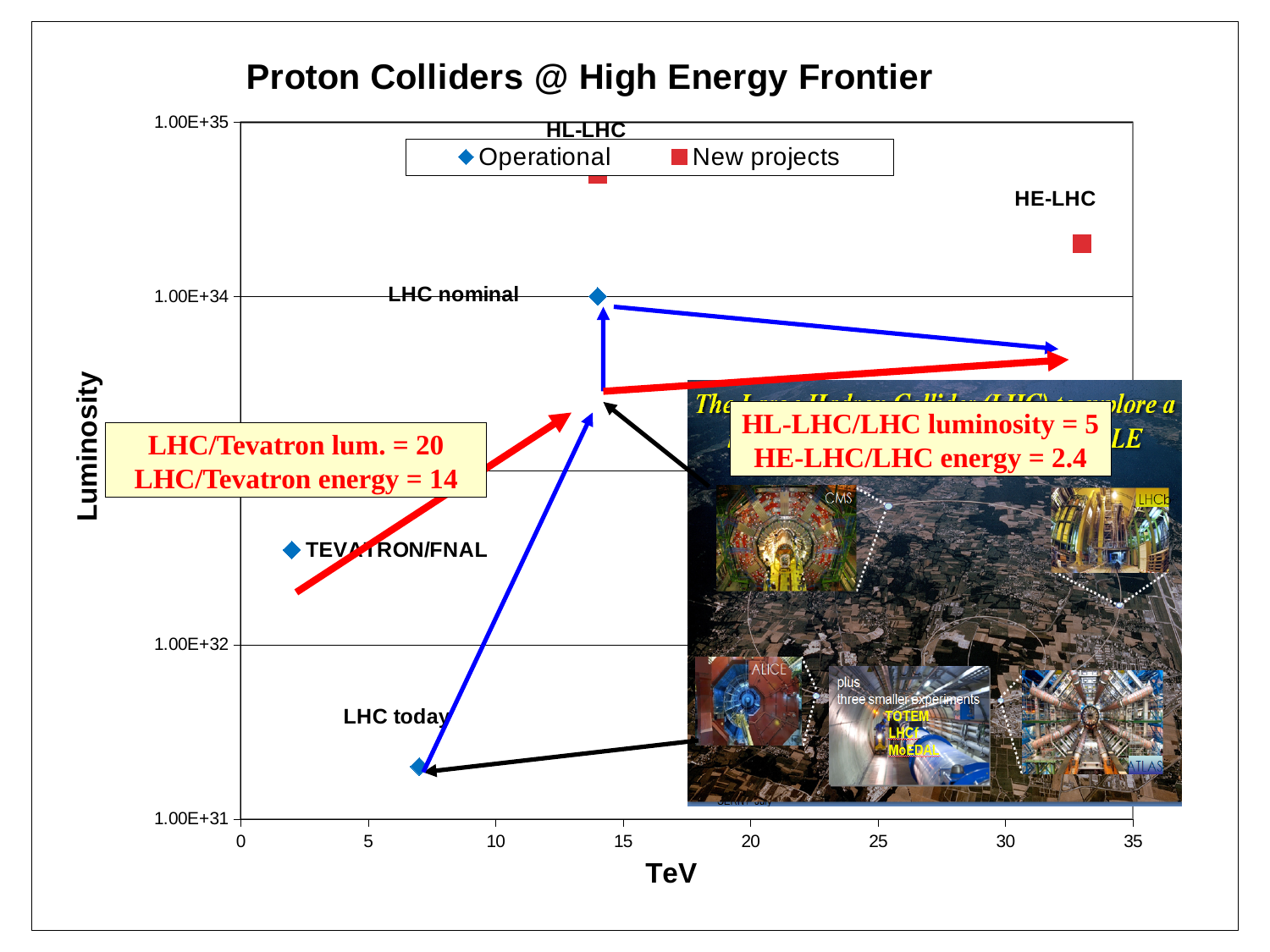
Which collider has the lowest luminosity on the chart? LHC today Is the luminosity for HE-LHC greater or less than 1.00E+34? greater Is the luminosity for TEVATRON/FNAL greater or less than 1.00E+32? greater Which collider has the highest luminosity on the chart? HL-LHC What are the two series named in the legend? Operational and New projects Which has the higher luminosity, HL-LHC or HE-LHC? HL-LHC What luminosity is plotted for LHC nominal? 1.00E+34 What is the title of the chart? Proton Colliders @ High Energy Frontier What kind of chart is shown on the slide? scatter chart Which collider has the highest energy (TeV) on the chart? HE-LHC How many series does the legend list? 2 Is the energy for LHC today greater or less than 10 TeV? less